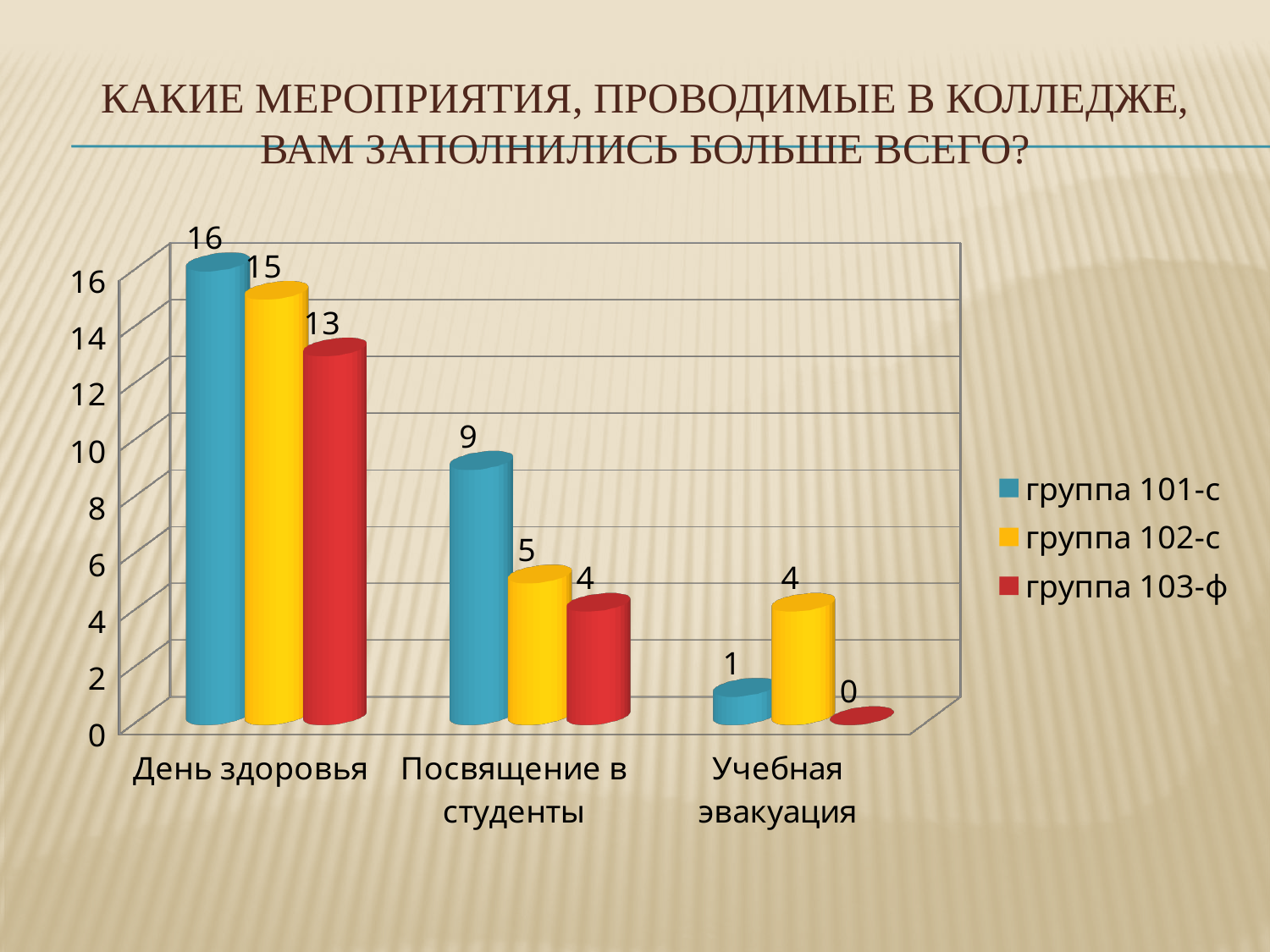
What is the difference between the values for группа 101-с and группа 103-ф in the День здоровья category? 3 Which category has the lowest value for группа 103-ф? Учебная эвакуация What kind of chart is shown on the slide? bar chart What is the value for группа 102-с in the Учебная эвакуация category? 4 Which category has the highest value for группа 102-с? День здоровья How many categories are shown on the x axis? 3 What colour represents группа 103-ф in the chart? red Do the values for группа 101-с rise or fall from left to right along the x axis? fall How many series does the legend list? 3 What is the value for группа 101-с in the День здоровья category? 16 What is the value for группа 103-ф in the Посвящение в студенты category? 4 Which is larger in the Учебная эвакуация category: группа 101-с or группа 102-с? группа 102-с